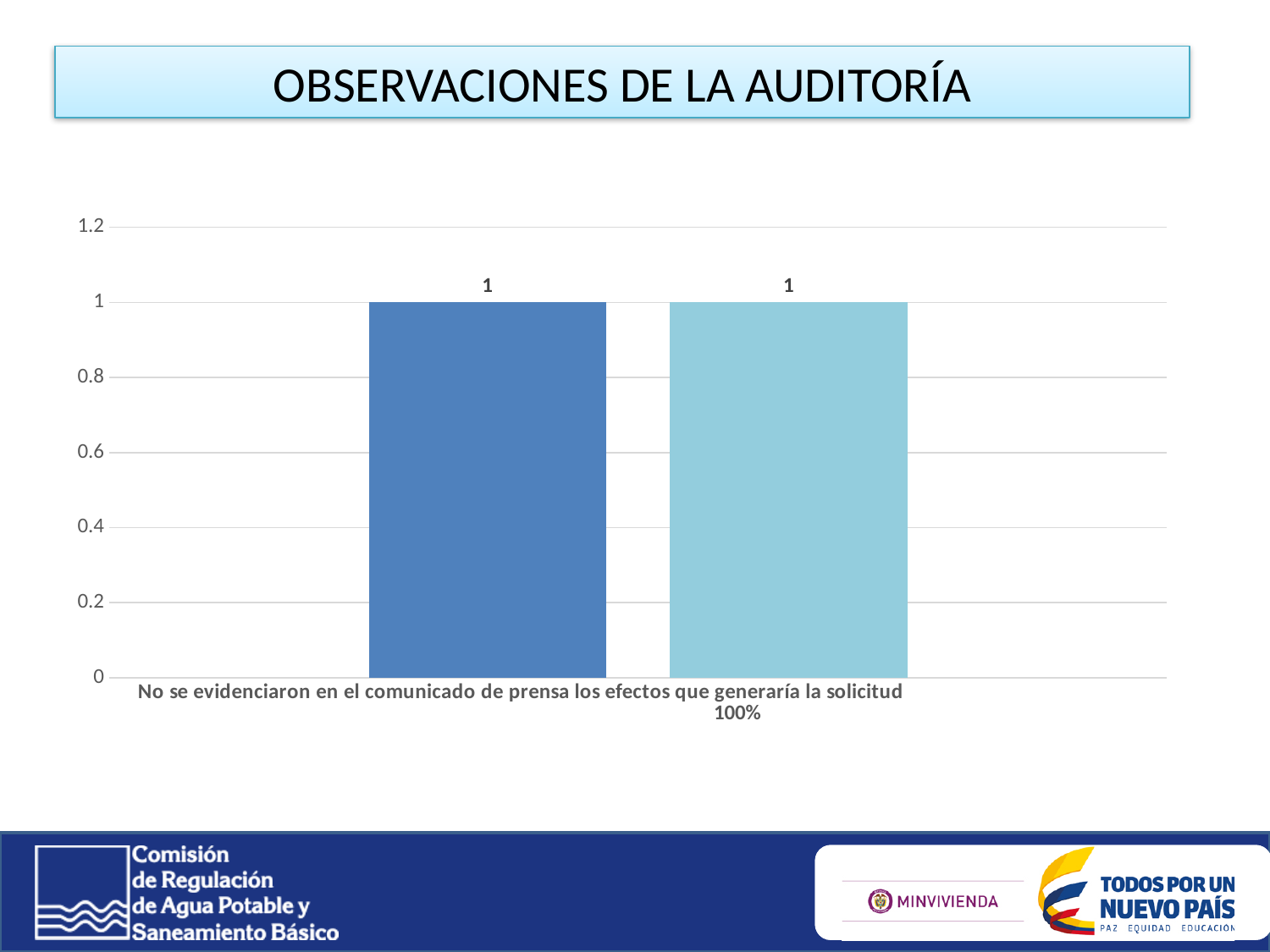
What is the value shown on the data label of the right (light blue) bar? 1 What is the difference between the values of the two bars? 0 What is the value shown on the data label of the left (dark blue) bar? 1 Is the value of the left bar larger than, smaller than, or equal to the value of the right bar? Equal What is the highest tick value shown on the vertical axis? 1.2 How many bars are plotted in the chart? 2 Is the value of the light blue bar greater or less than 1.2? less What percentage is printed beneath the category label on the horizontal axis? 100% What kind of chart is shown on the slide? Bar chart Is the value of the dark blue bar greater or less than 0.8? greater What is the title shown at the top of the slide above the chart? OBSERVACIONES DE LA AUDITORÍA